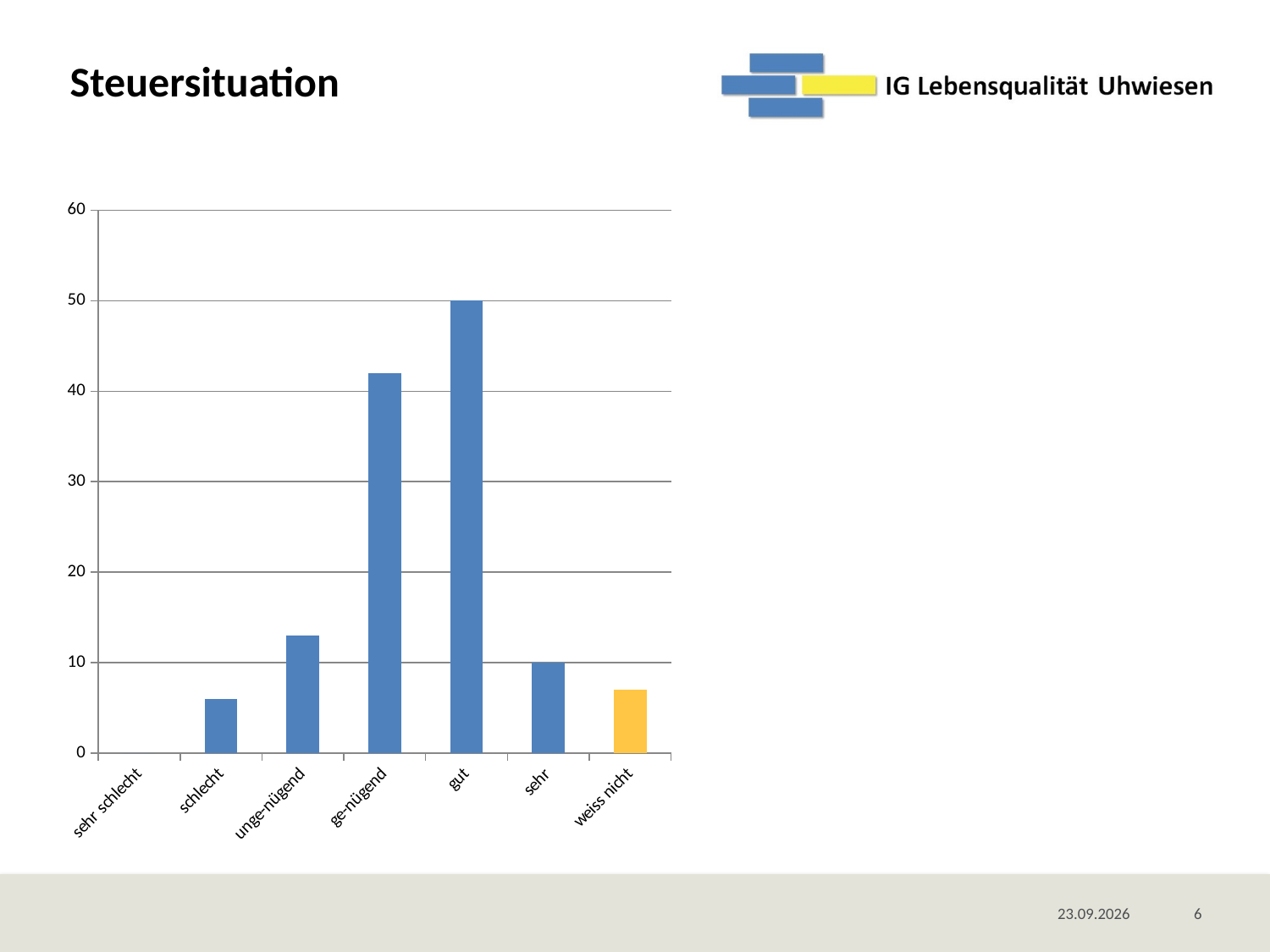
What kind of chart is shown on the slide? bar chart What is the difference between the values for "gut" and "sehr"? 40 Which is larger, the value for "ge-nügend" or the value for "gut"? gut How many categories are shown on the x axis of the chart? 7 Which category has the highest bar in the chart? gut Is the value for "ge-nügend" greater or less than 40? greater What is the title of the slide containing the chart? Steuersituation Is the value for "schlecht" greater or less than 10? less Is the value for "unge-nügend" greater or less than 10? greater Which category has the lowest value in the chart? sehr schlecht What is the value for "gut" in the chart? 50 What is the value for "sehr" in the chart? 10